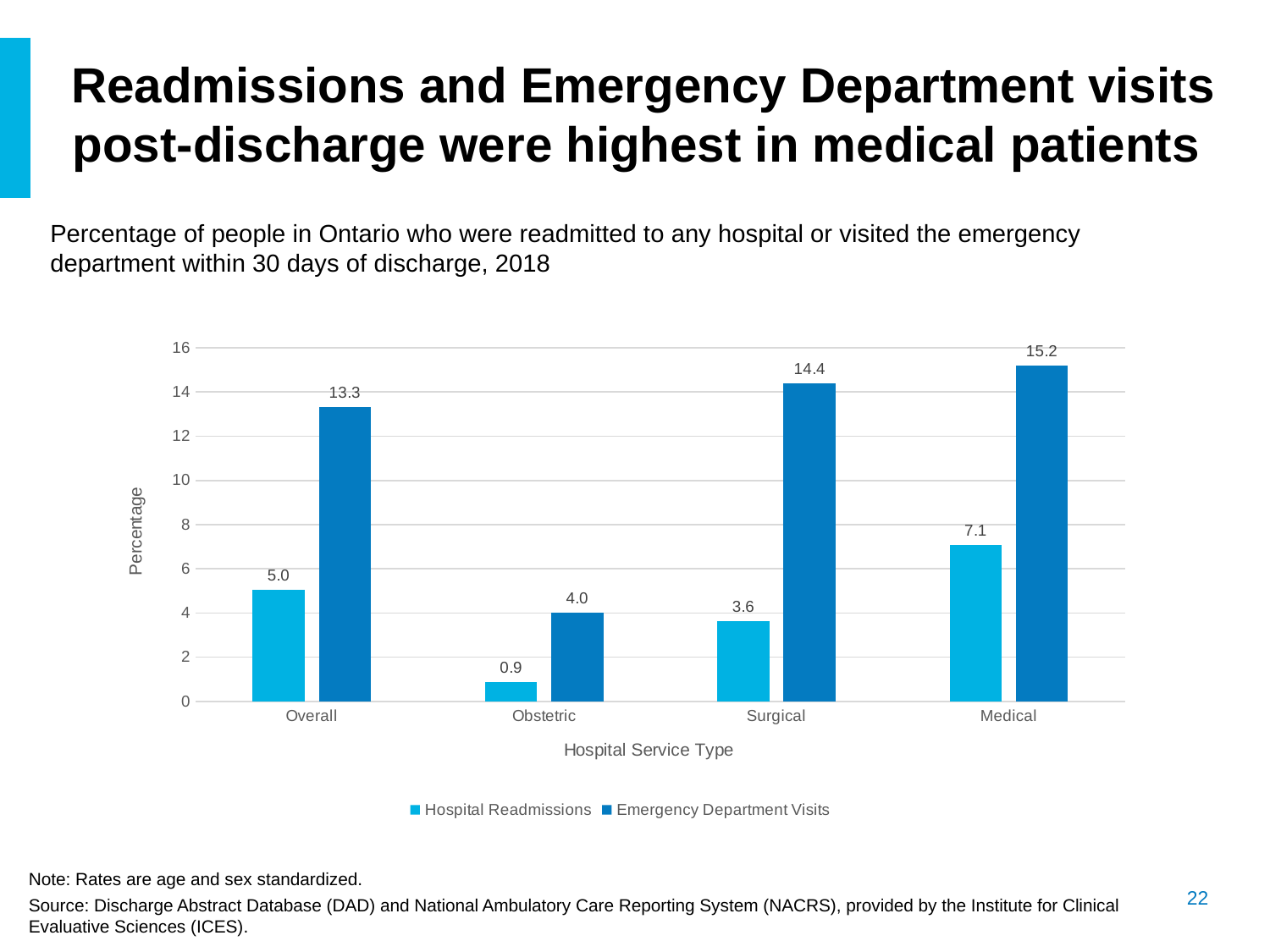
Which is larger: the Hospital Readmissions value for Surgical or for Overall? Overall What kind of chart is shown on the slide? Bar chart How many series does the legend list? 2 What is the Hospital Readmissions value for Medical? 7.1 Which hospital service type has the highest Emergency Department Visits value? Medical What is the label of the y axis? Percentage What is the Emergency Department Visits value for Obstetric? 4.0 Is the Emergency Department Visits value for Overall greater or less than 12? greater What is the Hospital Readmissions value for Overall? 5.0 How many hospital service types are shown on the x axis? 4 What is the difference between the Emergency Department Visits values for Medical and Surgical? 0.8 Which hospital service type has the lowest Hospital Readmissions value? Obstetric